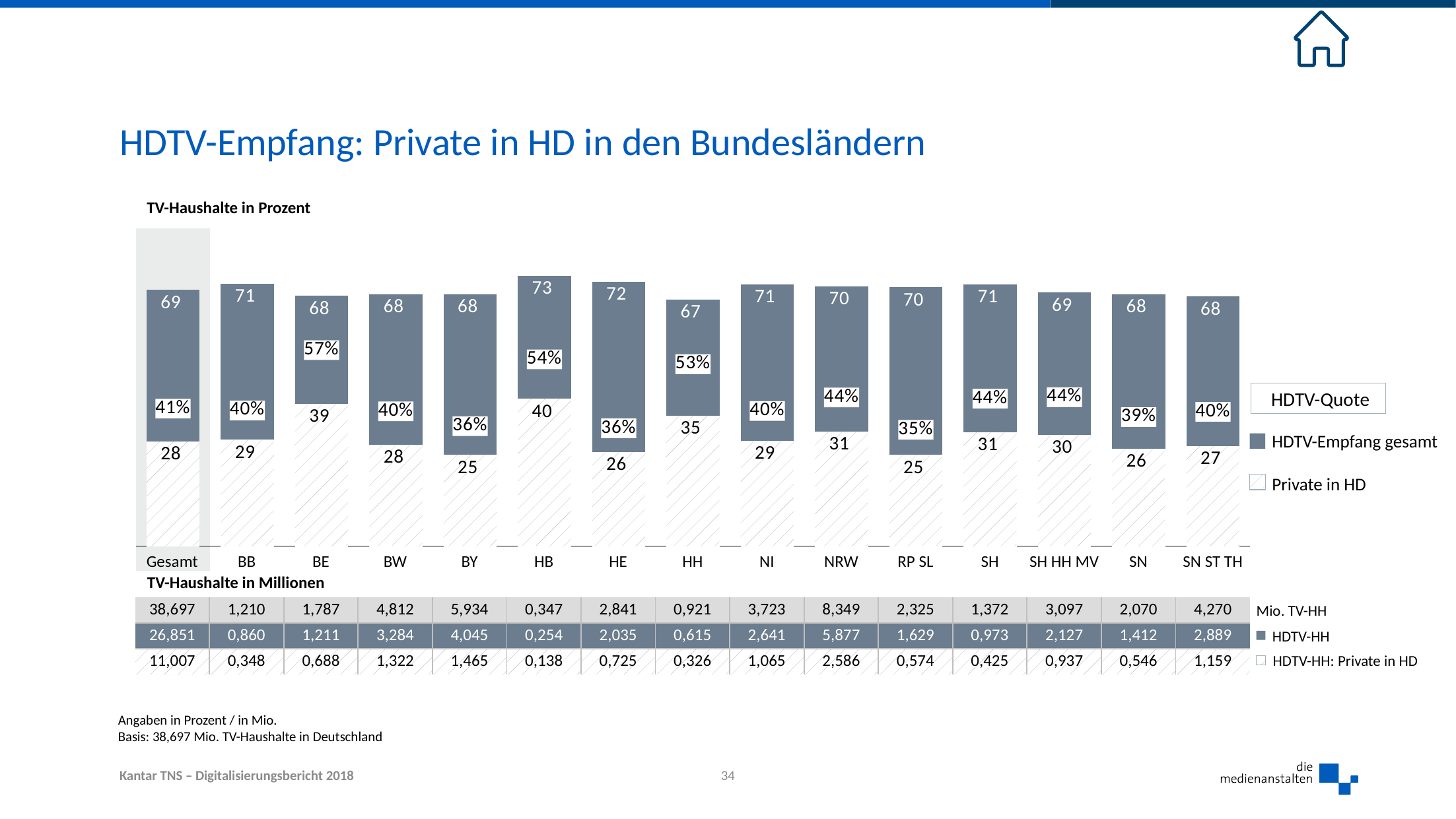
Which category has the highest HDTV-Empfang gesamt value? HB What is the HDTV-Quote shown for HH? 53% How many categories are shown on the x axis of the chart? 15 Which category has the lowest HDTV-Empfang gesamt value? HH What kind of chart is shown on the slide? Bar chart How many entries does the chart legend list? 3 Which category has the highest HDTV-Quote? BE What is the Private in HD value for BE? 39 What is the difference between the HDTV-Empfang gesamt values for HB and HH? 6 Which has a larger Private in HD value, BE or BW? BE Which category has the lowest HDTV-Quote? RP SL What is the HDTV-Empfang gesamt value for HB? 73